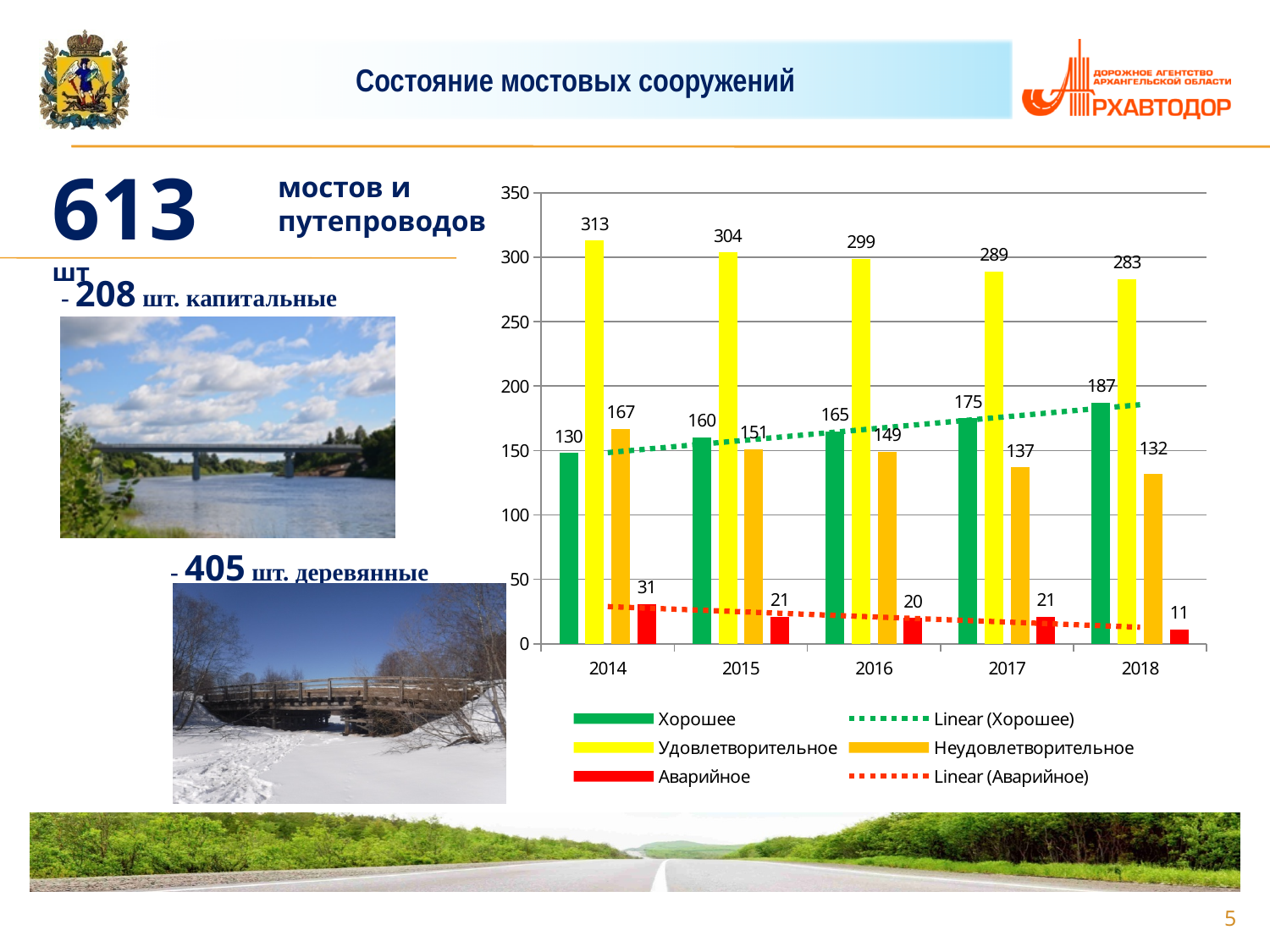
What is the difference between the Удовлетворительное values in 2014 and 2018? 30 What is the value of Хорошее in 2018? 187 What is the value of Удовлетворительное in 2014? 313 In which year is the Аварийное value lowest? 2018 What kind of chart is shown on the slide? bar chart Do the Хорошее values rise or fall from 2014 to 2018? rise How many entries does the legend list? 6 What is the value of Аварийное in 2018? 11 In 2017, which is larger: Хорошее or Неудовлетворительное? Хорошее How many years are shown on the x axis? 5 Is the value for Неудовлетворительное in 2015 greater or less than 200? less In which year is the Удовлетворительное value highest? 2014